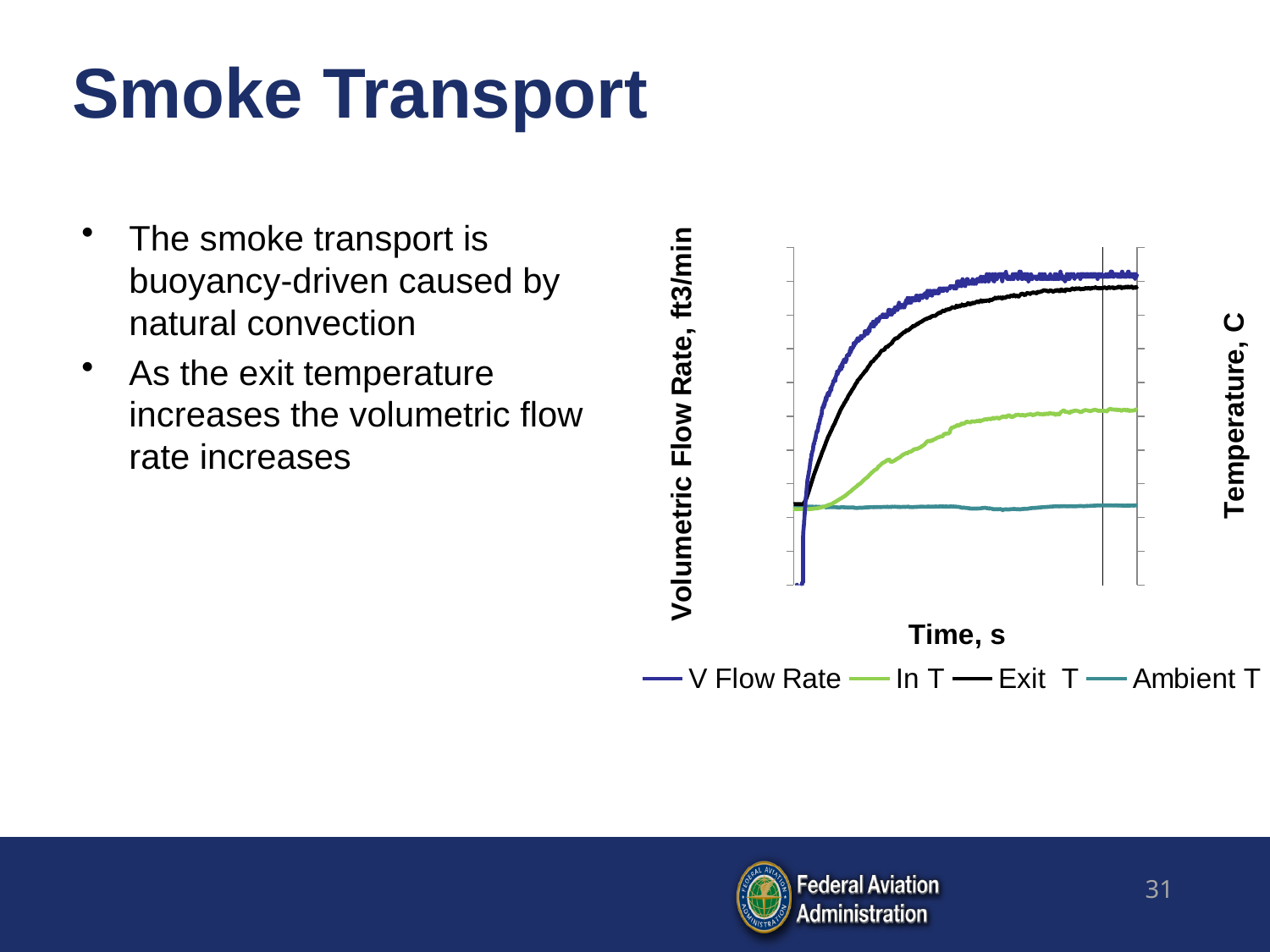
What is the title of the left y axis of the chart? Volumetric Flow Rate, ft3/min How many series does the chart legend list? 4 What kind of chart is shown on the slide? Line chart Does the Exit T line rise or fall along the time axis? Rises Which series stays roughly flat over the whole time range? Ambient T Does the V Flow Rate line rise or fall as time increases? Rises Which series is plotted highest on the chart at the end of the time range? V Flow Rate Which series is plotted lowest on the chart at the end of the time range? Ambient T What is the title of the x axis of the chart? Time, s At the end of the time range, which line is plotted higher: In T or Ambient T? In T At the end of the time range, which line is plotted higher: In T or Exit T? Exit T